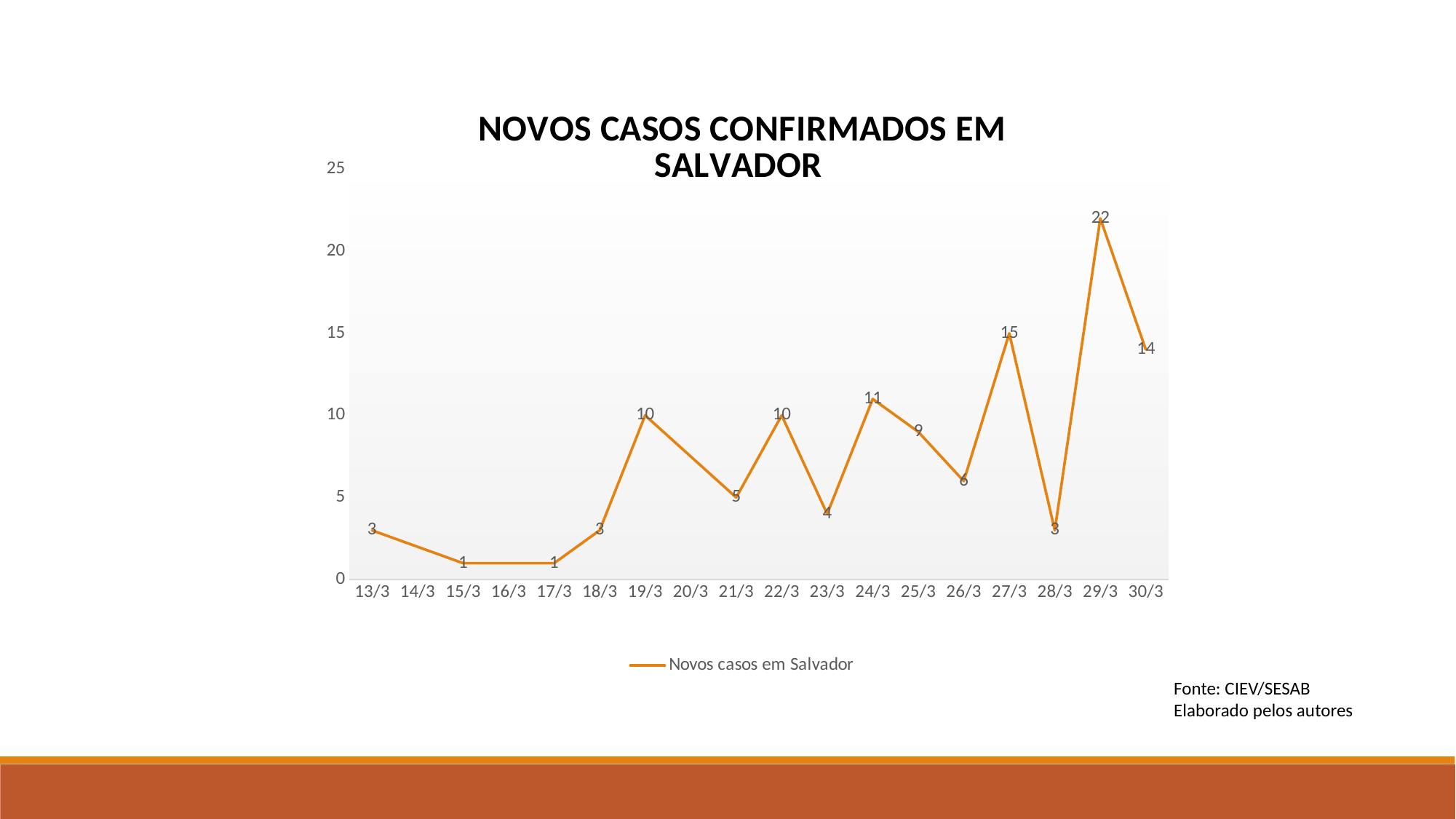
Is the value for 29/3 greater or less than 20? greater What is the value for 27/3? 15 What is the difference between the values for 27/3 and 28/3? 12 What is the difference between the values for 29/3 and 30/3? 8 What is the value for 29/3? 22 What is the value for 23/3? 4 How many date labels are shown on the x axis? 18 What type of chart is shown on the slide? Line chart What is the title of the chart? NOVOS CASOS CONFIRMADOS EM SALVADOR On which date is the number of new cases highest? 29/3 How many series does the legend list? 1 Which has a larger value, 24/3 or 25/3? 24/3